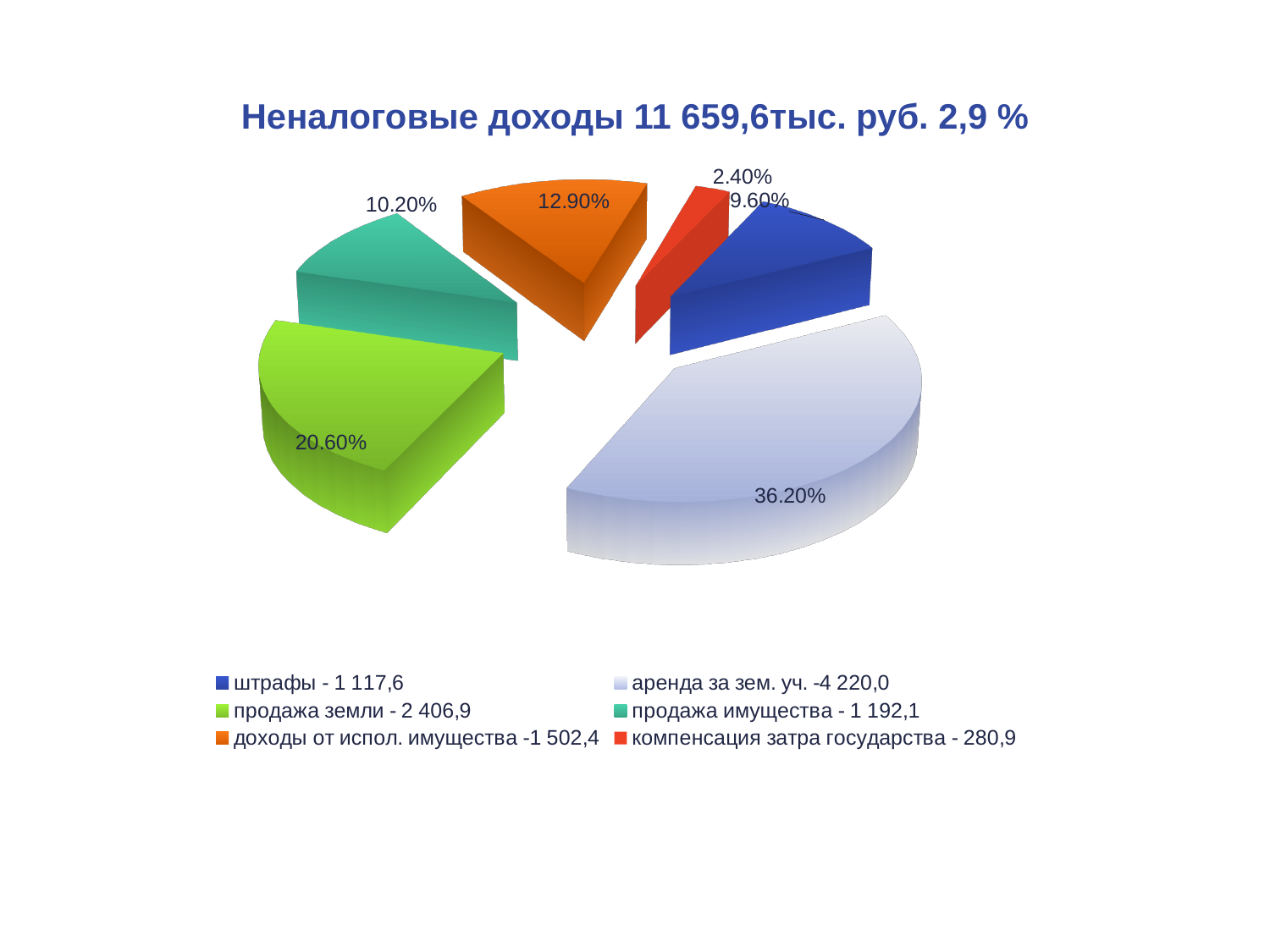
What is the difference in percentage points between the 'аренда за зем. уч.' slice and the 'продажа земли' slice? 15.60% What is the title of the chart? Неналоговые доходы 11 659,6тыс. руб. 2,9 % What share of the pie does the slice for 'штрафы' represent? 9.60% What share of the pie does the slice for 'доходы от испол. имущества' represent? 12.90% Which slice is larger: 'продажа земли' or 'доходы от испол. имущества'? продажа земли What share of the pie does the slice for 'продажа имущества' represent? 10.20% Which category has the largest slice of the pie? аренда за зем. уч. How many slices does the pie chart have? 6 Which category has the smallest slice of the pie? компенсация затра государства What kind of chart is shown on the slide? pie chart